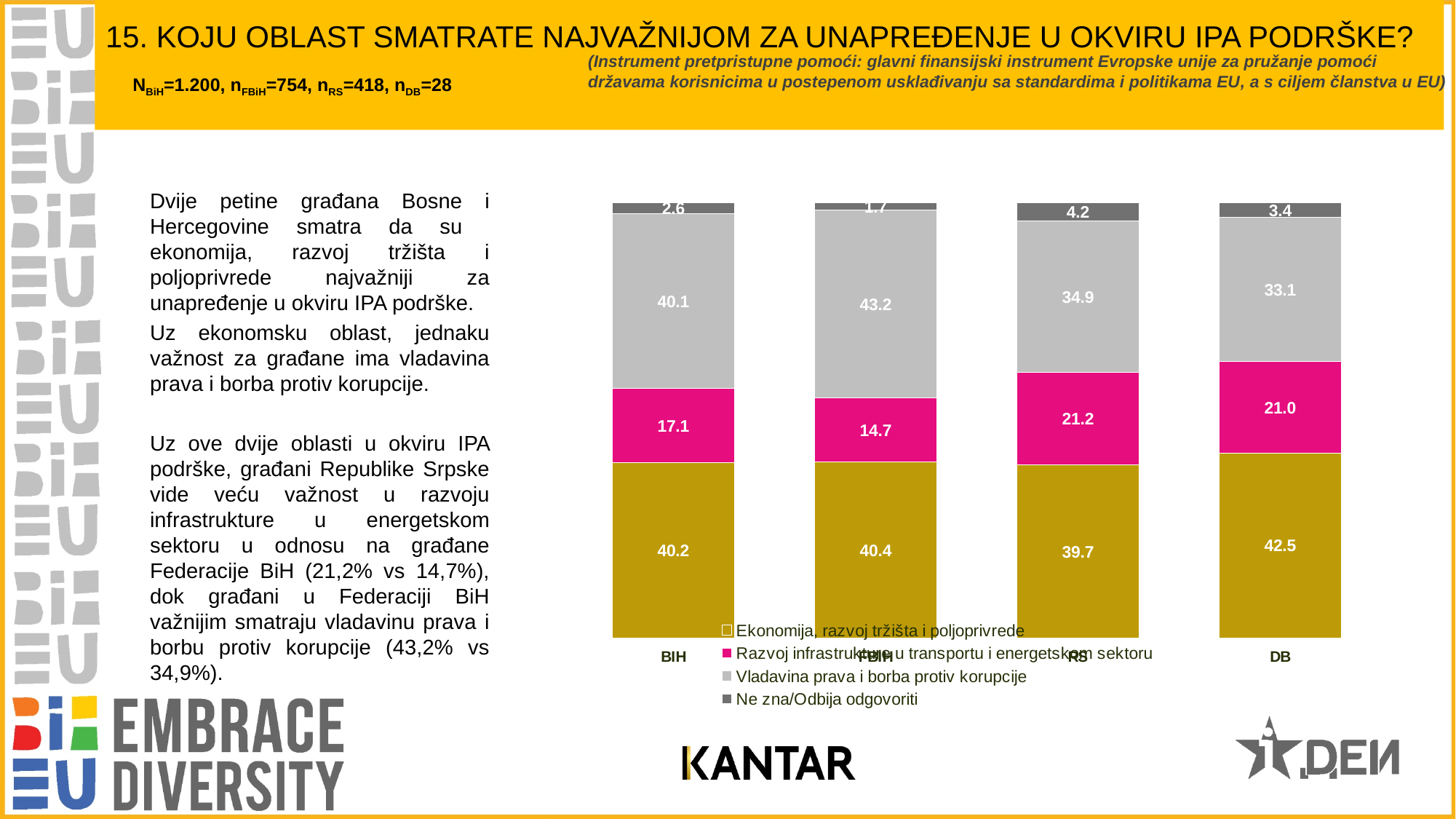
Which is larger: the 'Razvoj infrastrukture u transportu i energetskom sektoru' value for RS or for FBiH? RS Which category has the highest value for 'Ekonomija, razvoj tržišta i poljoprivrede'? DB What is the value for 'Ne zna/Odbija odgovoriti' in the DB bar? 3.4 What kind of chart is shown on the slide? Stacked bar chart Which category has the lowest value for 'Ne zna/Odbija odgovoriti'? FBiH How many categories are shown on the x axis of the chart? 4 What is the total of the stacked bar for RS? 100.0 What is the value for 'Vladavina prava i borba protiv korupcije' in the FBiH bar? 43.2 What is the difference between the 'Vladavina prava i borba protiv korupcije' values for FBiH and RS? 8.3 How many series does the chart legend list? 4 What is the value for 'Razvoj infrastrukture u transportu i energetskom sektoru' in the RS bar? 21.2 What is the value for 'Ekonomija, razvoj tržišta i poljoprivrede' in the BiH bar? 40.2